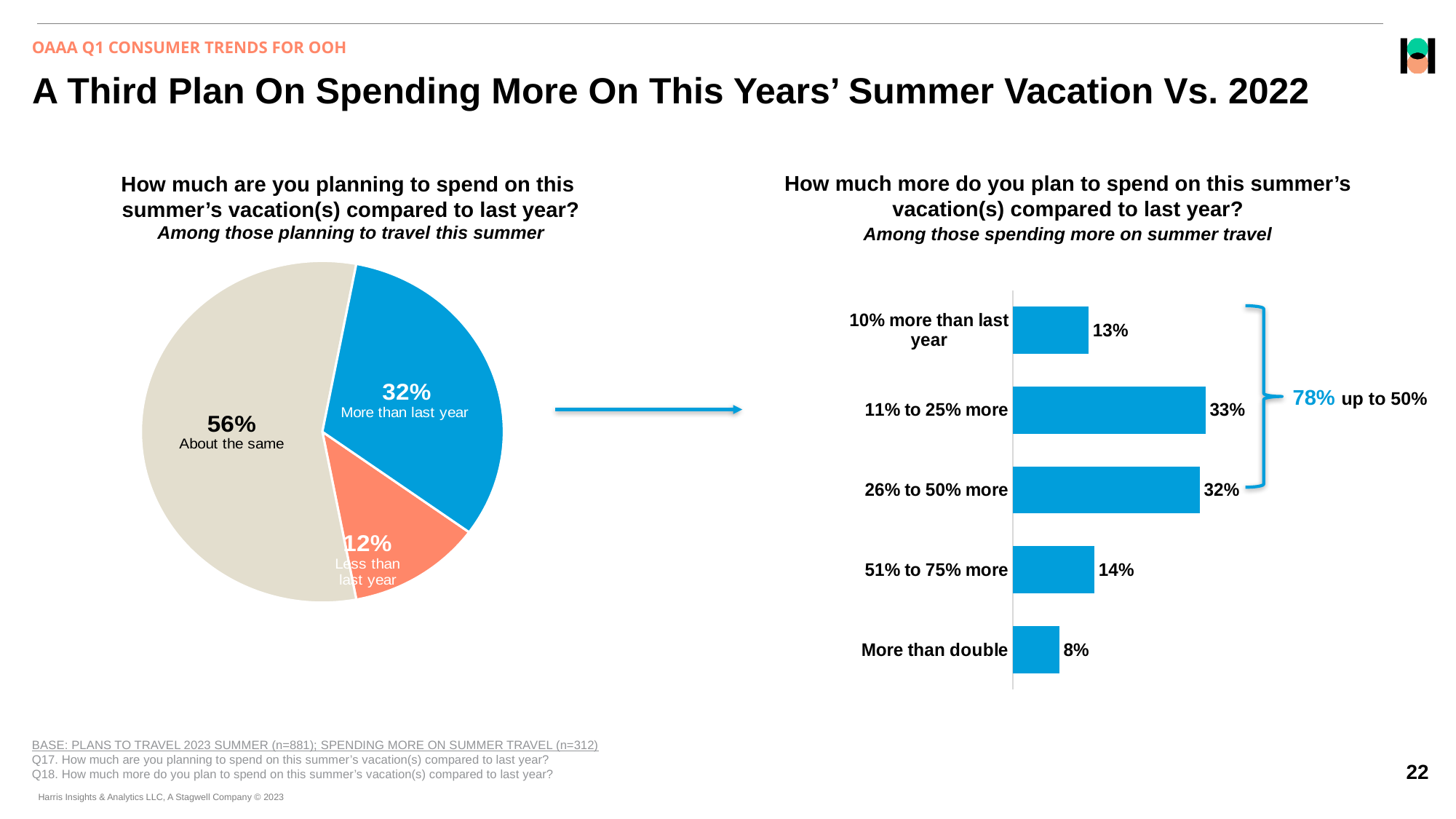
In the pie chart on the left, which category has the smallest share? Less than last year In the bar chart on the right, what is the value for 'More than double'? 8% What kind of chart is shown on the right side of the slide? Bar chart In the pie chart on the left, what share of respondents plan to spend more than last year? 32% In the bar chart on the right, which category has the lowest value? More than double In the pie chart on the left, what is the difference between the 'About the same' share and the 'More than last year' share? 24% In the bar chart on the right, what percentage does the bracket annotation say plan to spend up to 50% more? 78% In the pie chart on the left, how many slices are there? 3 In the pie chart on the left, what share of respondents plan to spend about the same as last year? 56% In the bar chart on the right, what is the difference between '51% to 75% more' and '10% more than last year'? 1% In the bar chart on the right, how many categories are shown? 5 In the bar chart on the right, what is the value for '11% to 25% more'? 33%